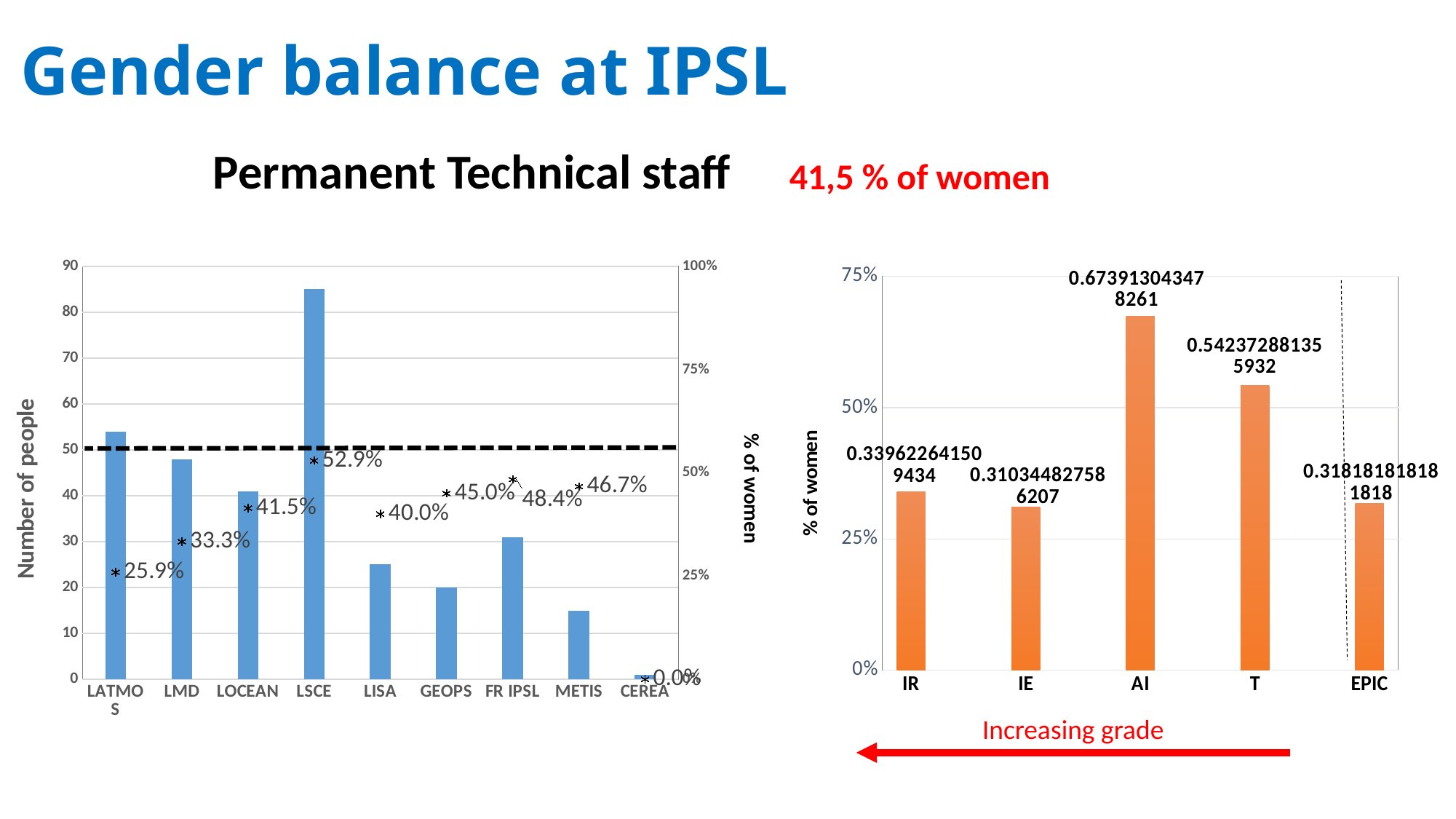
In the left chart, is the number of people at METIS greater or less than 20? less In the left chart, how many labs are shown on the x axis? 9 In the left chart, which has more people, LATMOS or LMD? LATMOS In the left chart, what is the percentage of women at LATMOS? 25.9% What kind of chart is the right chart? bar chart In the left chart, what is the difference in percentage of women between LSCE and LMD? 19.6 percentage points In the left chart, which lab has the lowest percentage of women? CEREA In the right chart, which grade has the highest percentage of women? AI In the left chart, which lab has the highest number of people? LSCE In the right chart, what is the value shown for grade T? 0.542372881355932 In the left chart, is the number of people at LSCE greater or less than 80? greater In the left chart, what is the percentage of women at LSCE? 52.9%